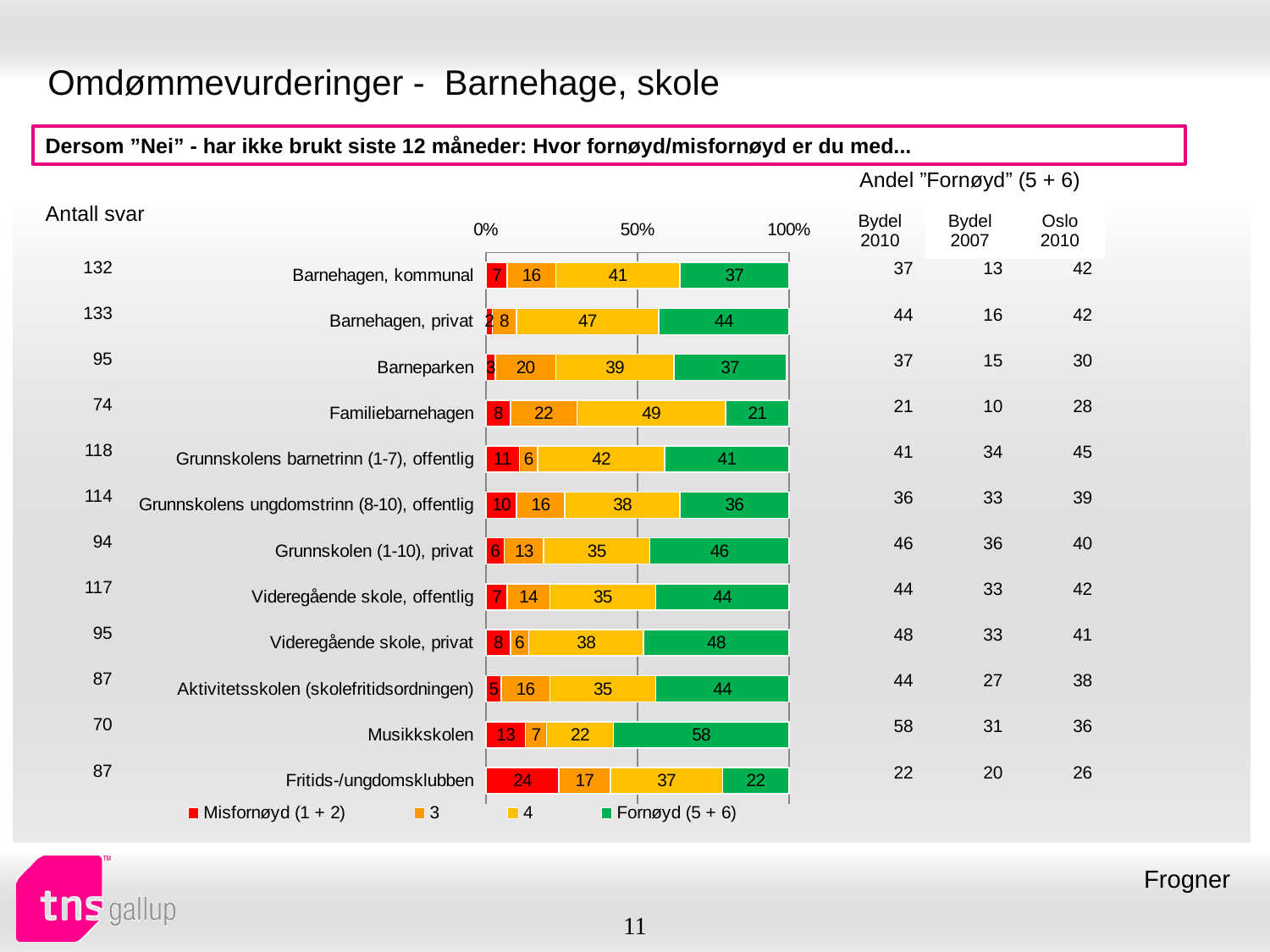
What is the value of the '3' segment for Barneparken? 20 What kind of chart is shown on the slide? Stacked bar chart Which category has the highest Fornøyd (5 + 6) value? Musikkskolen What is the difference between the Fornøyd (5 + 6) values for Musikkskolen and Fritids-/ungdomsklubben? 36 How many categories are shown in the chart? 12 What is the value of the '4' segment for Familiebarnehagen? 49 Which has a larger Fornøyd (5 + 6) value: Grunnskolen (1-10), privat or Barnehagen, kommunal? Grunnskolen (1-10), privat How many series does the legend list? 4 What is the Fornøyd (5 + 6) value for Musikkskolen? 58 Which category has the highest Misfornøyd (1 + 2) value? Fritids-/ungdomsklubben What is the Misfornøyd (1 + 2) value for Fritids-/ungdomsklubben? 24 What is the first entry in the chart legend? Misfornøyd (1 + 2)